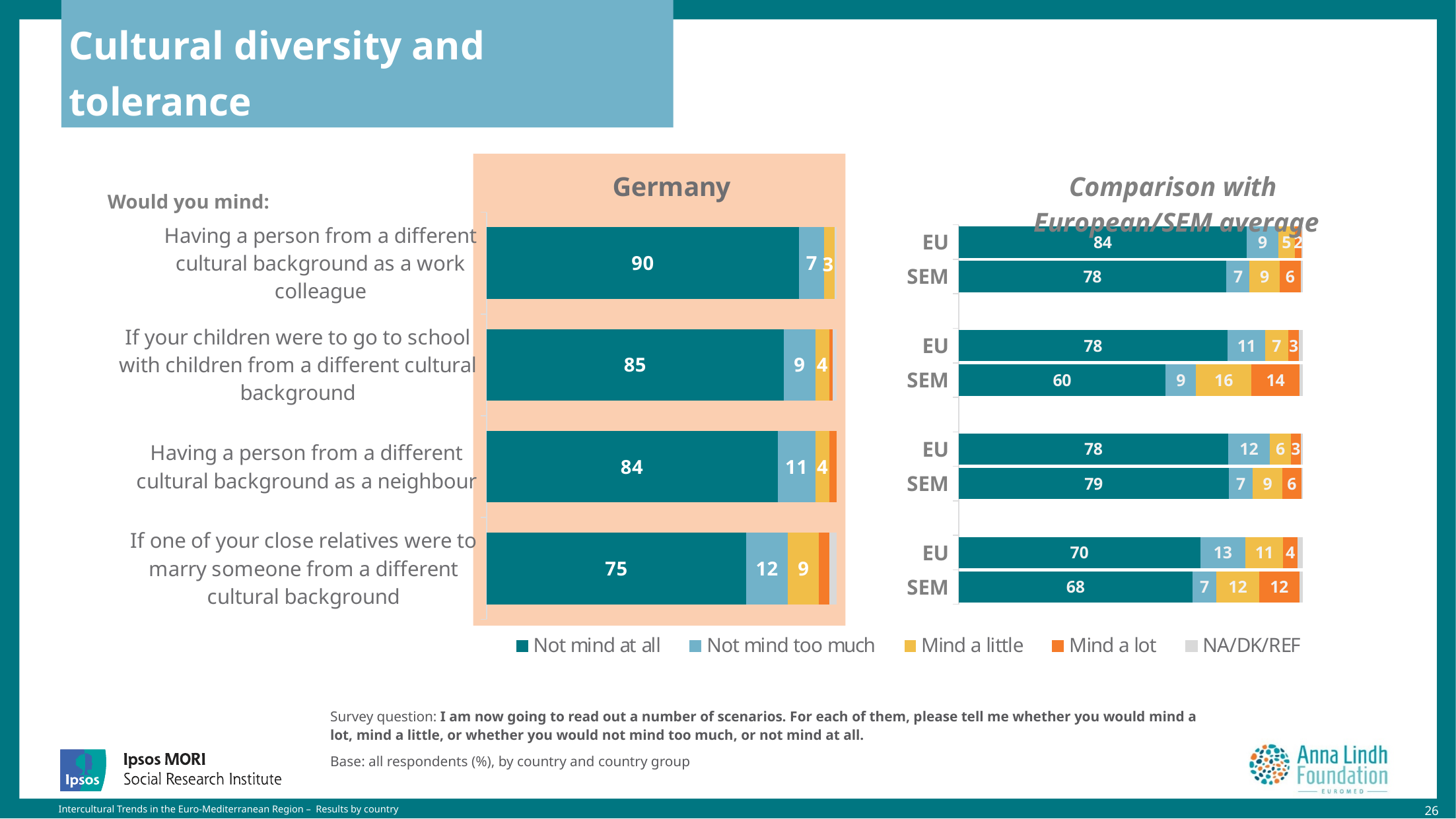
In the Germany chart, what is the difference between the 'Not mind at all' values for the work colleague scenario and the close relative marrying scenario? 15 In the Germany chart, which scenario has the highest 'Not mind at all' value? Having a person from a different cultural background as a work colleague What kind of chart is the Germany chart? Stacked bar chart In the Comparison with European/SEM average chart, what is the SEM 'Mind a lot' value for the school scenario? 14 In the Germany chart, what percentage would not mind at all having a person from a different cultural background as a work colleague? 90 In the Germany chart, what is the 'Not mind too much' value for one of your close relatives marrying someone from a different cultural background? 12 In the Germany chart, which scenario has the lowest 'Not mind at all' value? If one of your close relatives were to marry someone from a different cultural background In the Comparison with European/SEM average chart, what is the SEM 'Not mind at all' value for children going to school with children from a different cultural background? 60 How many scenarios are shown in the Germany chart? 4 How many series does the legend list? 5 In the Comparison with European/SEM average chart, what is the difference between the EU and SEM 'Not mind at all' values for the school scenario? 18 In the Comparison with European/SEM average chart, which is larger for the neighbour scenario's 'Not mind at all' value: EU or SEM? SEM